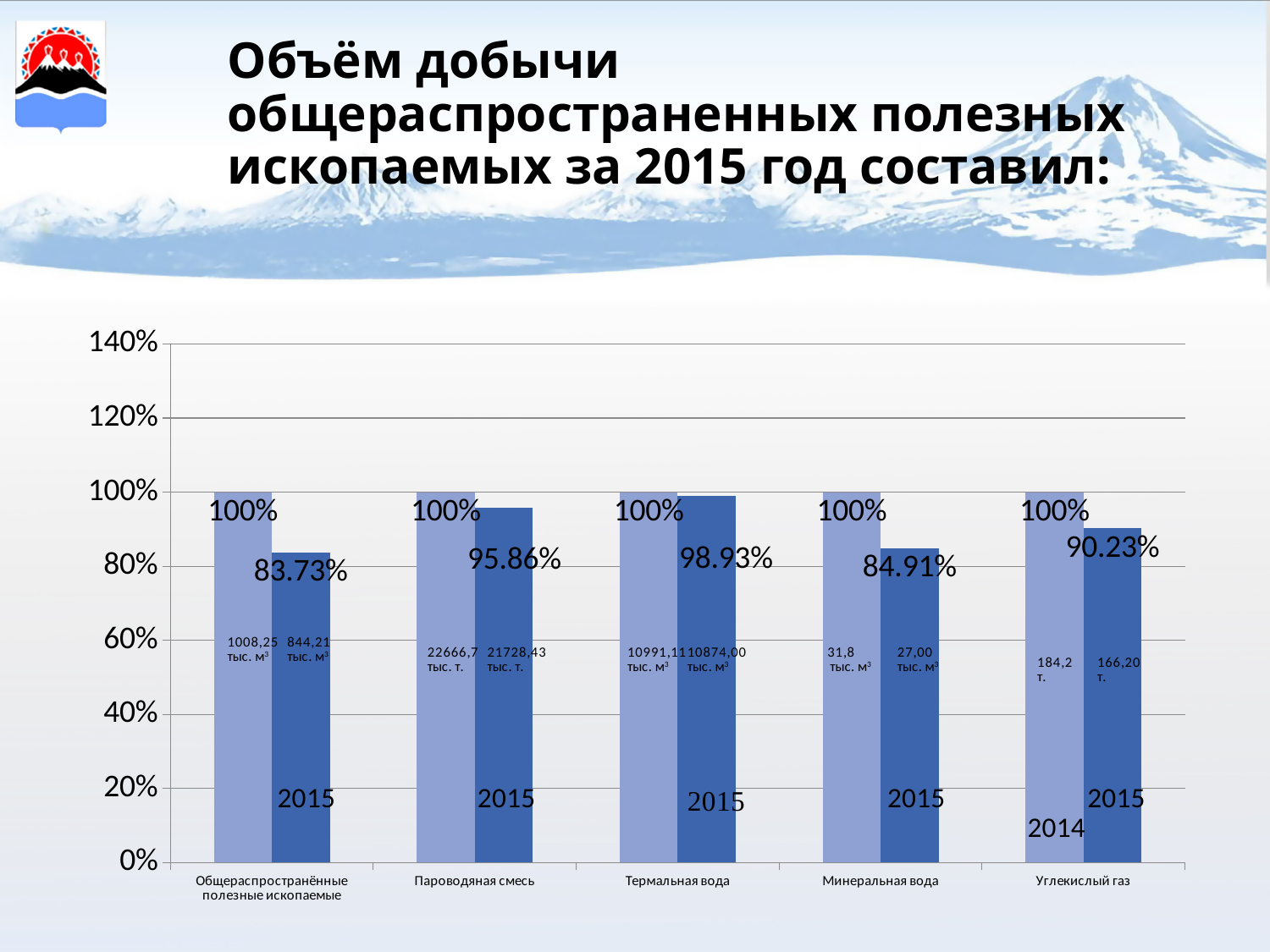
Which category has the highest 2015 value? Термальная вода What is the 2015 value for Углекислый газ? 90.23% What is the 2015 value for Пароводяная смесь? 95.86% Which is larger, the 2015 value for Углекислый газ or for Минеральная вода? Углекислый газ What is the 2015 value for Термальная вода? 98.93% What value do all the 2014 bars show? 100% What kind of chart is shown on the slide? bar chart What is the 2015 value for Общераспространённые полезные ископаемые? 83.73% What is the difference between the 2014 value (100%) and the 2015 value for Пароводяная смесь? 4.14% What is the 2015 value for Минеральная вода? 84.91% Which category has the lowest 2015 value? Общераспространённые полезные ископаемые How many categories are shown on the x axis of the chart? 5